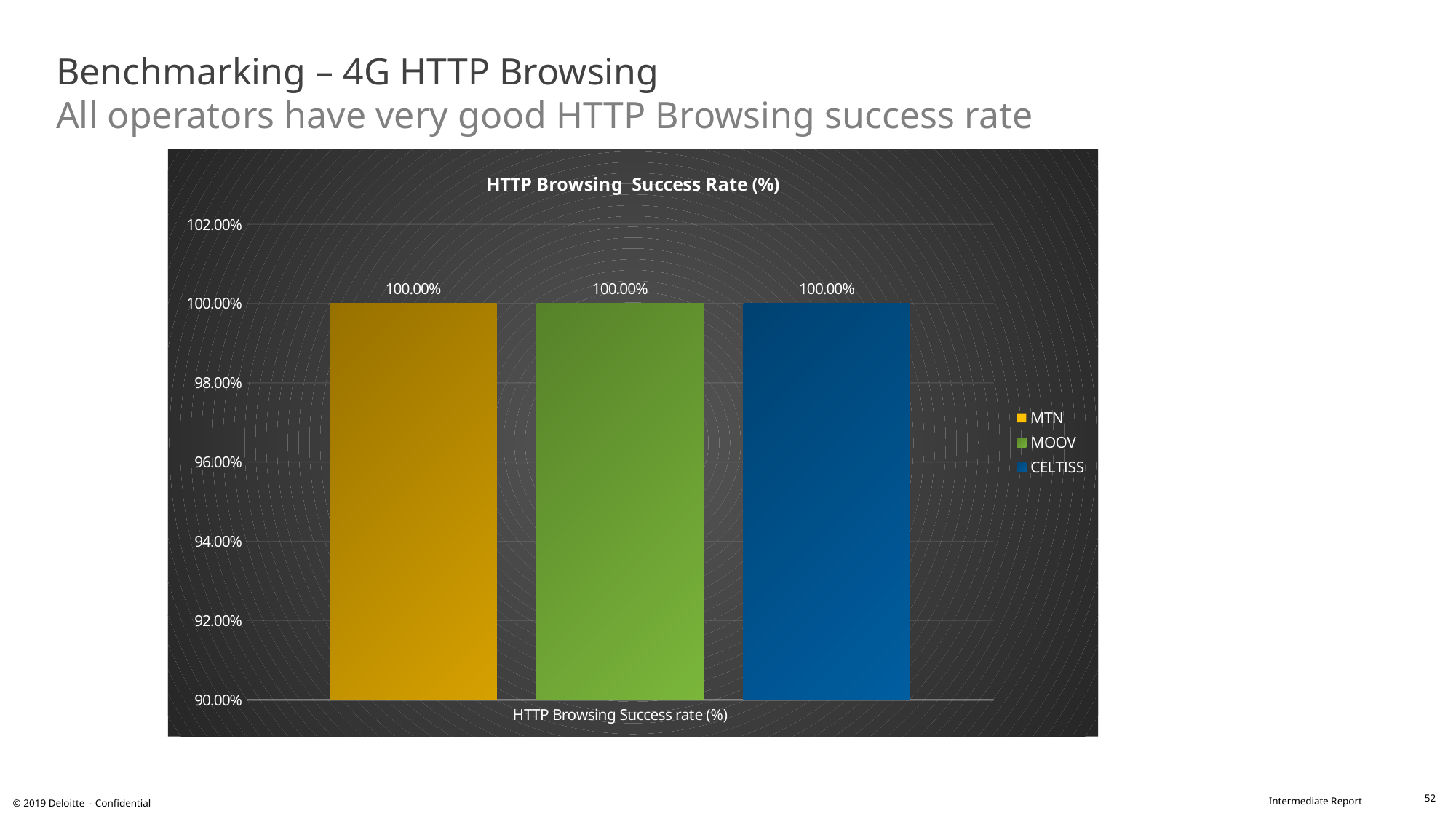
What is the title of the chart? HTTP Browsing Success Rate (%) How many series does the legend list? 3 Is the value for MOOV greater or less than 98.00%? greater What kind of chart is shown on the slide? Bar chart Which operator is represented by the blue bar? CELTISS What is the HTTP Browsing success rate for MTN? 100.00% What is the HTTP Browsing success rate for MOOV? 100.00% What is the HTTP Browsing success rate for CELTISS? 100.00% How many bars are plotted in the chart? 3 What is the difference between the HTTP Browsing success rates of MTN and CELTISS? 0.00% Is the value for CELTISS greater or less than 102.00%? less What is the total of the three operators' HTTP Browsing success rates? 300.00%